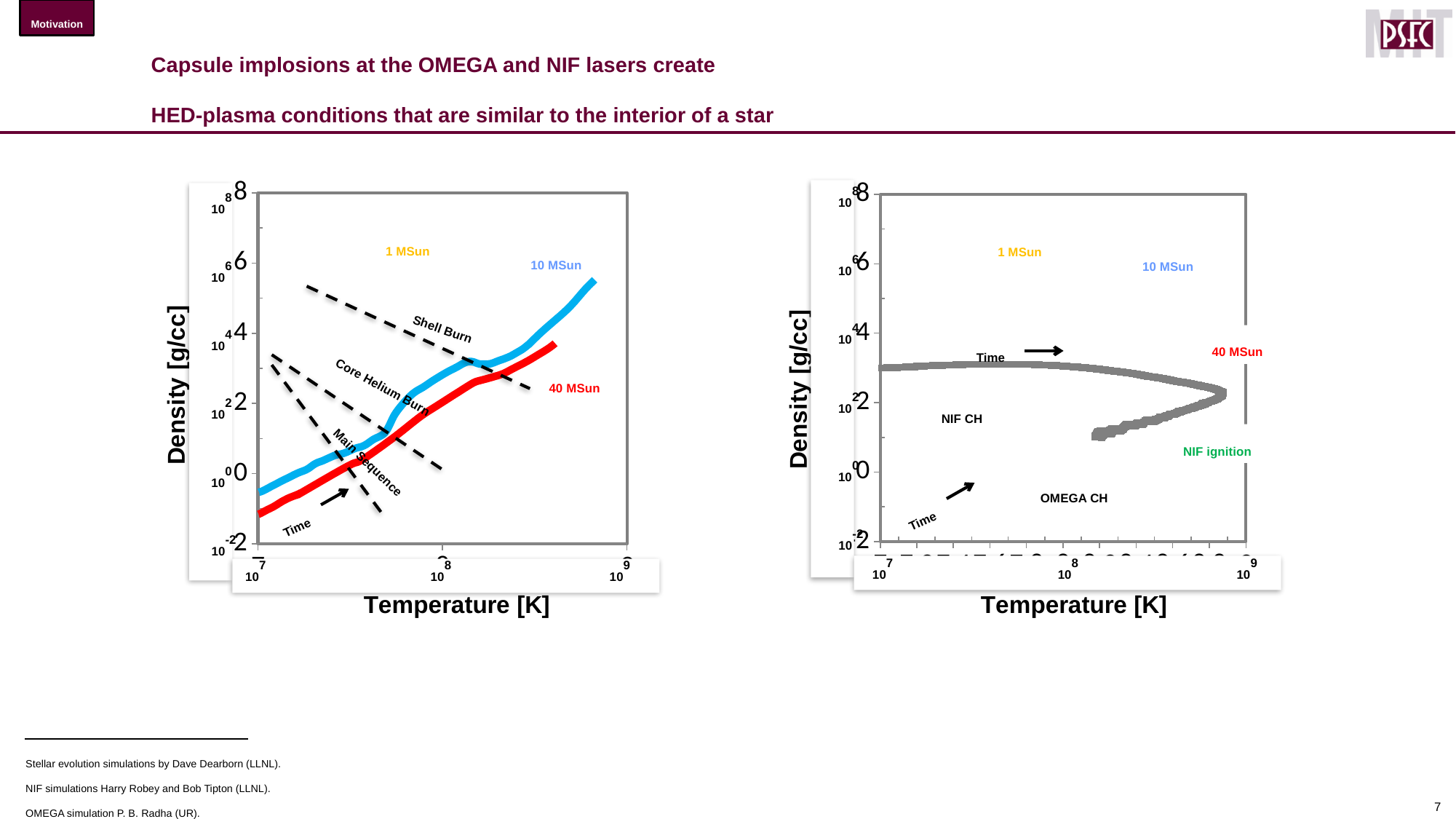
What are the lowest and highest temperature tick values shown on the x axis of the left chart? 10^7 and 10^9 On the left chart, which curve is drawn in red? 40 MSun What is the x-axis label of the right chart? Temperature [K] On the right chart, is the density of the flat upper portion of the gray curve greater or less than 10^4 g/cc? less What kind of chart is the left chart (Density vs Temperature with stellar tracks)? line chart On the left chart, at the highest temperatures shown, which curve reaches the higher density, 10 MSun or 40 MSun? 10 MSun On the right chart, which label is shown in green near the lower right end of the gray curve? NIF ignition What is the y-axis label of the left chart? Density [g/cc] On the left chart, do the 10 MSun and 40 MSun curves rise or fall as temperature increases? rise On the right chart, is the density of the flat upper portion of the gray curve greater or less than 10^2 g/cc? greater On the left chart, is the density at the right end of the 10 MSun curve greater or less than 10^4 g/cc? greater